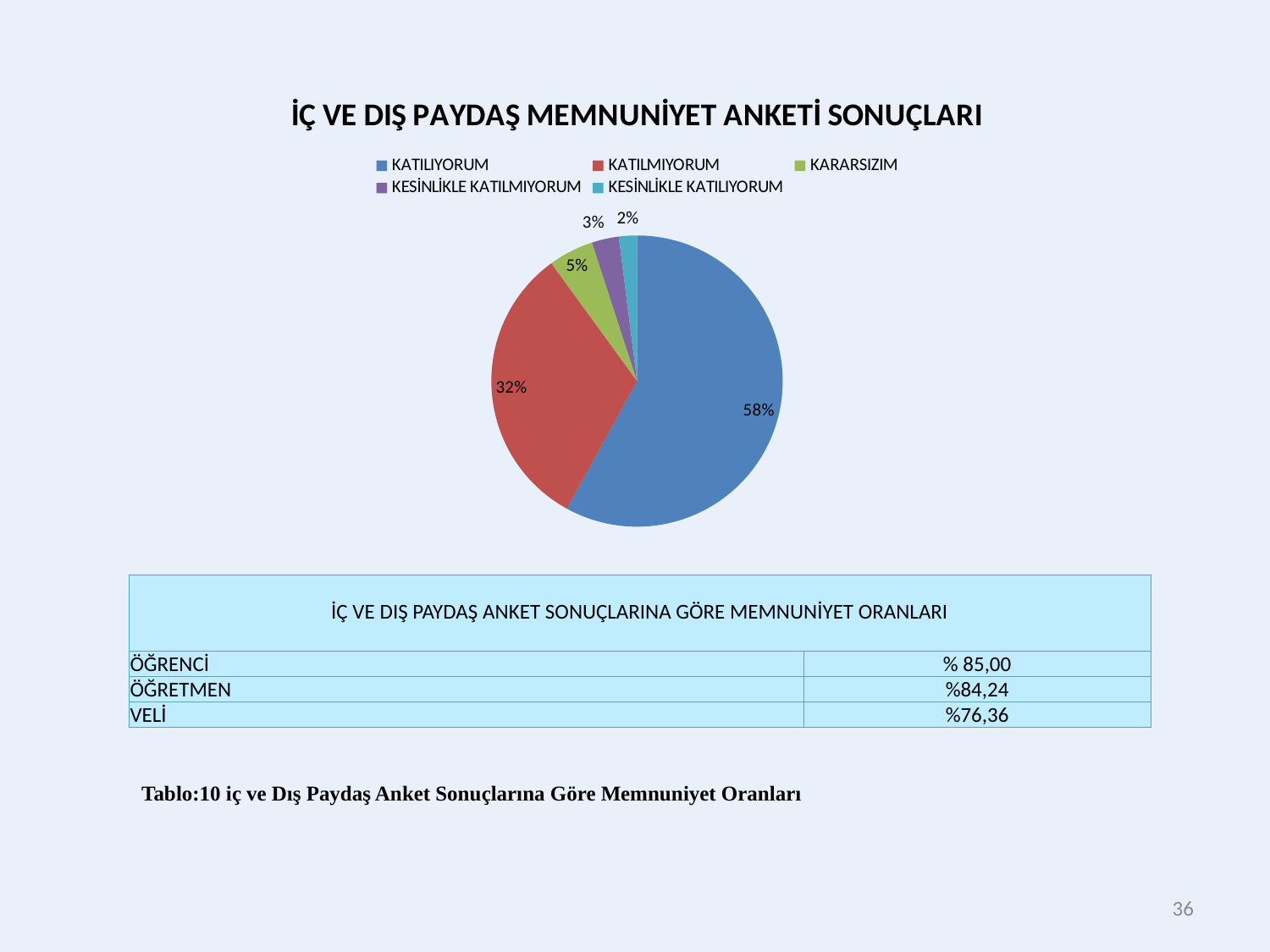
What is the difference in percentage points between the KATILIYORUM and KATILMIYORUM slices? 26 What share of the pie does KATILIYORUM represent? 58% How many categories does the pie chart show? 5 What share of the pie does KATILMIYORUM represent? 32% What share of the pie does KARARSIZIM represent? 5% Which category has the largest slice of the pie? KATILIYORUM Which category has the smallest slice of the pie? KESİNLİKLE KATILIYORUM What type of chart is shown on the slide? Pie chart What is the title of the chart? İÇ VE DIŞ PAYDAŞ MEMNUNİYET ANKETİ SONUÇLARI Which slice is larger, KARARSIZIM or KESİNLİKLE KATILMIYORUM? KARARSIZIM